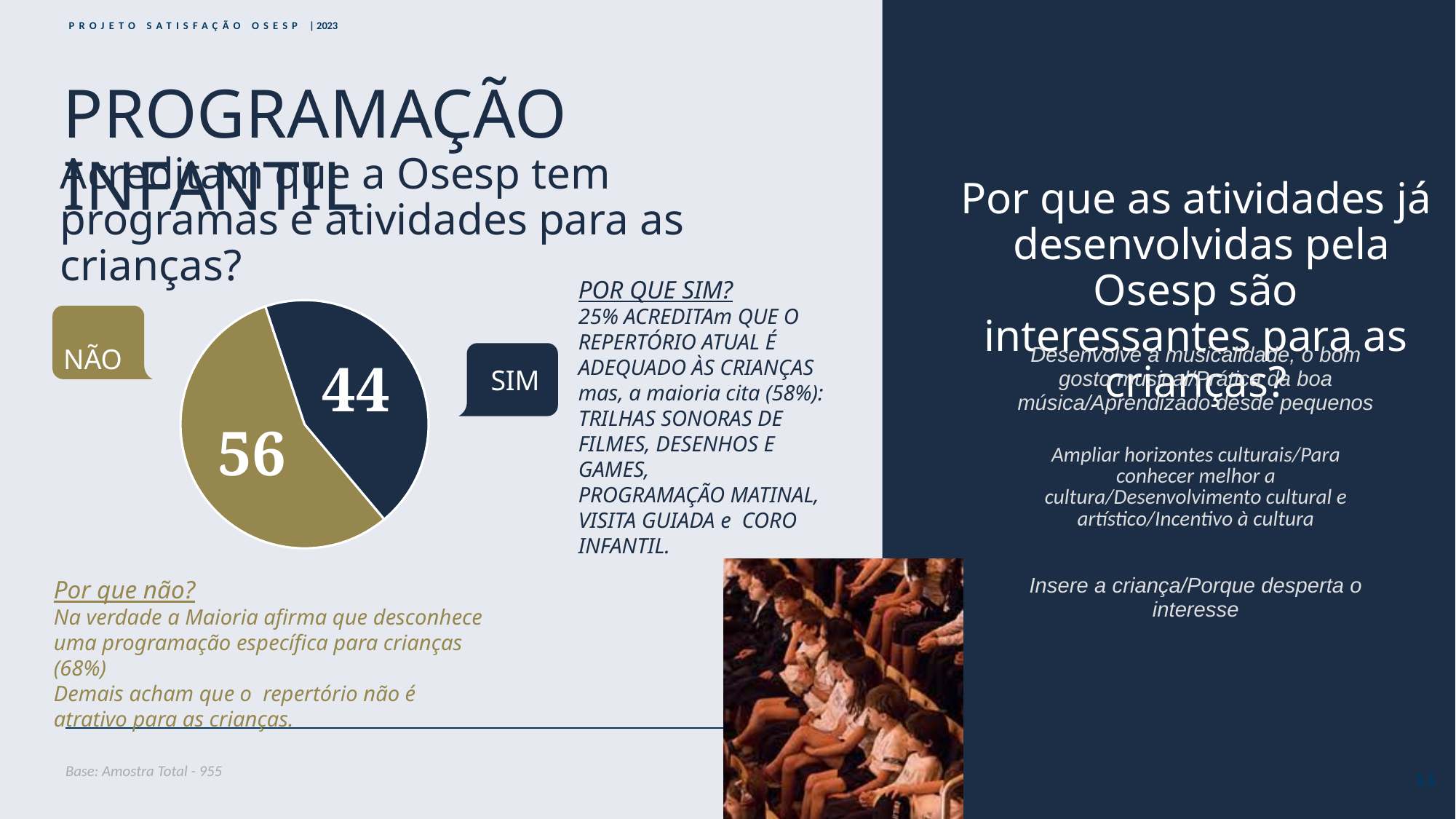
Which is larger in the pie chart, NÃO or SIM? NÃO How many slices does the pie chart have? 2 What colour is the NÃO slice of the pie chart? gold What is the value shown for the SIM slice of the pie chart? 44 What is the total of the two values shown in the pie chart? 100 What colour is the SIM slice of the pie chart? dark navy blue Which slice of the pie chart is the largest? NÃO Which slice of the pie chart is the smallest? SIM What type of chart is shown on the slide? pie chart What share of the pie does the SIM slice represent? 44% What is the difference between the NÃO value and the SIM value in the pie chart? 12 What is the value shown for the NÃO slice of the pie chart? 56